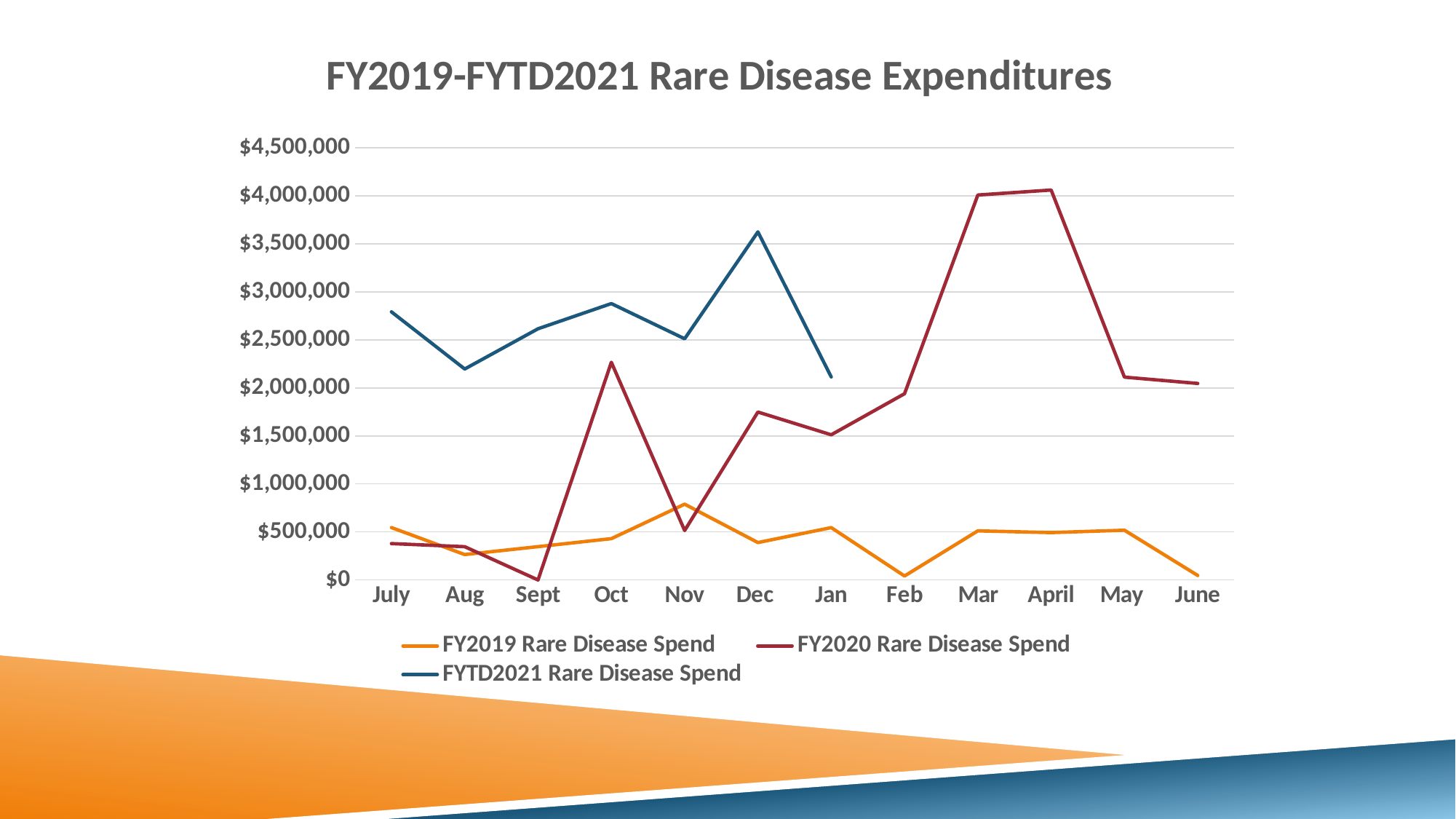
In which month is the FYTD2021 Rare Disease Spend highest? Dec In Nov, which is larger: the FY2019 Rare Disease Spend or the FY2020 Rare Disease Spend? FY2019 Rare Disease Spend How many months are shown on the x axis? 12 How many months have a plotted value for the FYTD2021 Rare Disease Spend series? 7 In which month is the FY2020 Rare Disease Spend lowest? Sept What type of chart is shown on the slide? Line chart Is the FY2019 Rare Disease Spend for Nov greater or less than $1,000,000? less What is the title of the chart? FY2019-FYTD2021 Rare Disease Expenditures Does the FY2020 Rare Disease Spend rise or fall from Feb to Mar? Rise How many series does the legend list? 3 Is the FYTD2021 Rare Disease Spend for Dec greater or less than $3,500,000? greater In which month is the FY2019 Rare Disease Spend highest? Nov